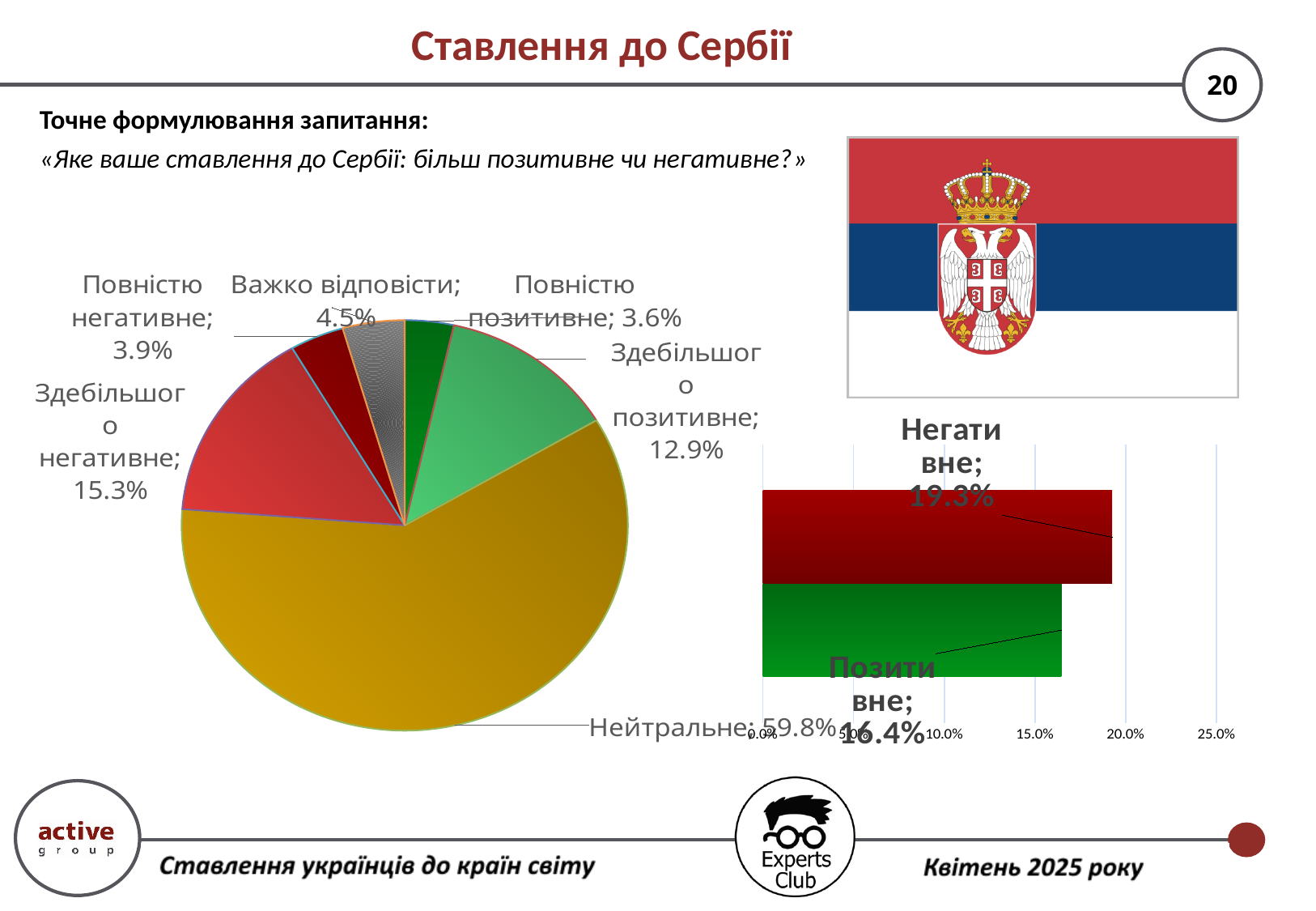
In the bar chart on the right, which is larger, "Негативне" or "Позитивне"? Негативне In the pie chart, what is the value for "Важко відповісти"? 4.5% In the bar chart on the right, what is the value for "Негативне"? 19.3% In the pie chart, how many categories are shown? 6 What type of chart is the chart on the left of the slide? pie chart In the pie chart, which category has the largest share? Нейтральне In the pie chart, what is the difference between "Здебільшого негативне" and "Здебільшого позитивне"? 2.4% In the bar chart on the right, what is the value for "Позитивне"? 16.4% In the pie chart, what share of respondents answered "Нейтральне"? 59.8% In the pie chart, which category has the smallest share? Повністю позитивне In the pie chart, what is the value for "Здебільшого негативне"? 15.3% In the pie chart, what is the value for "Здебільшого позитивне"? 12.9%